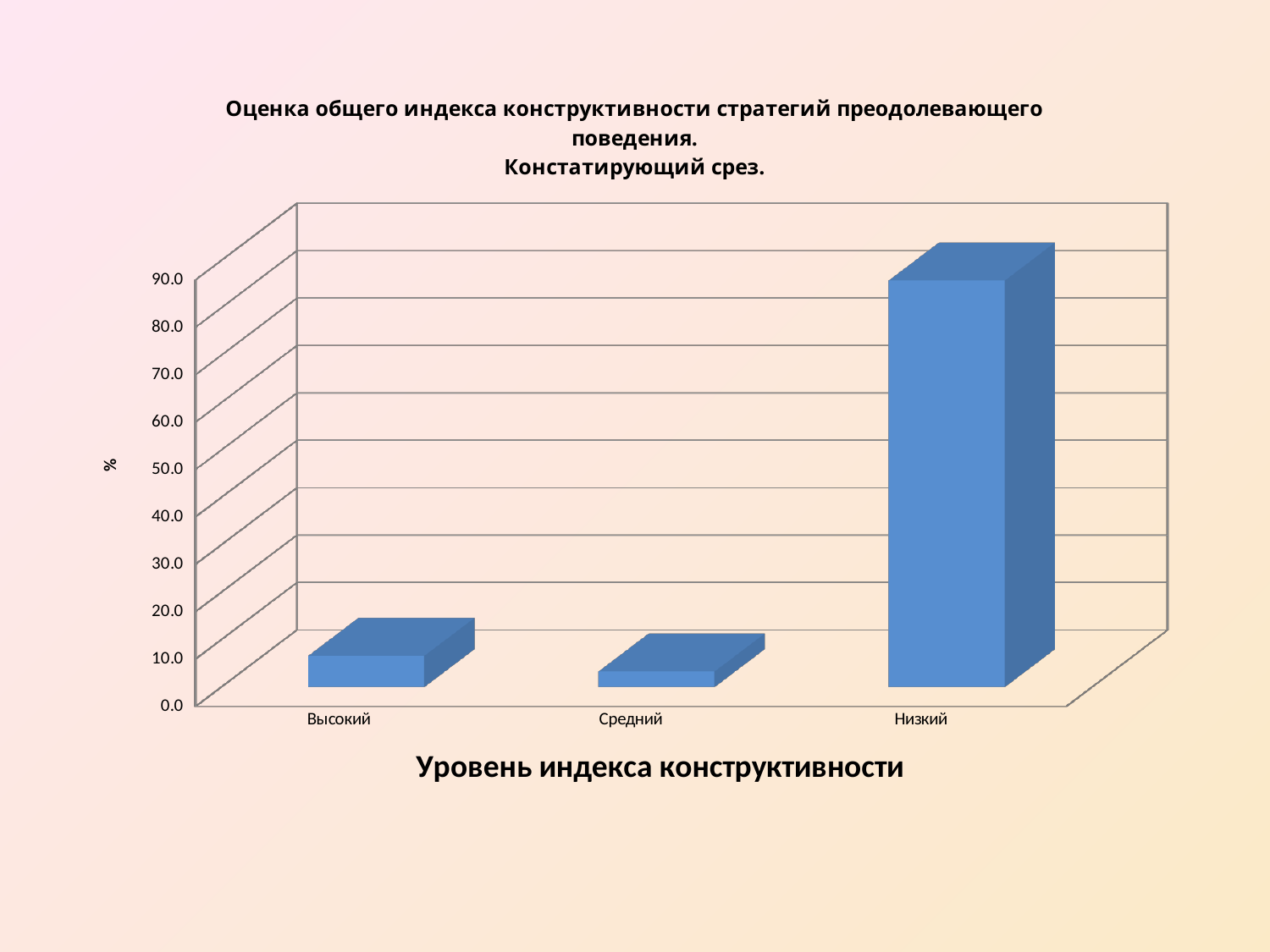
What is the title of the horizontal axis of the chart? Уровень индекса конструктивности Which category has the lowest value in the chart? Средний How many categories are shown on the x axis of the chart? 3 Is the value for Низкий greater or less than 70? greater Is the value for Средний greater or less than 20? less Which is larger, the value for Высокий or the value for Средний? Высокий What is the label of the vertical axis of the chart? % Is the value for Низкий greater or less than 50? greater Which category has the highest value in the chart? Низкий What kind of chart is shown on the slide? bar chart Which is larger, the value for Низкий or the value for Высокий? Низкий